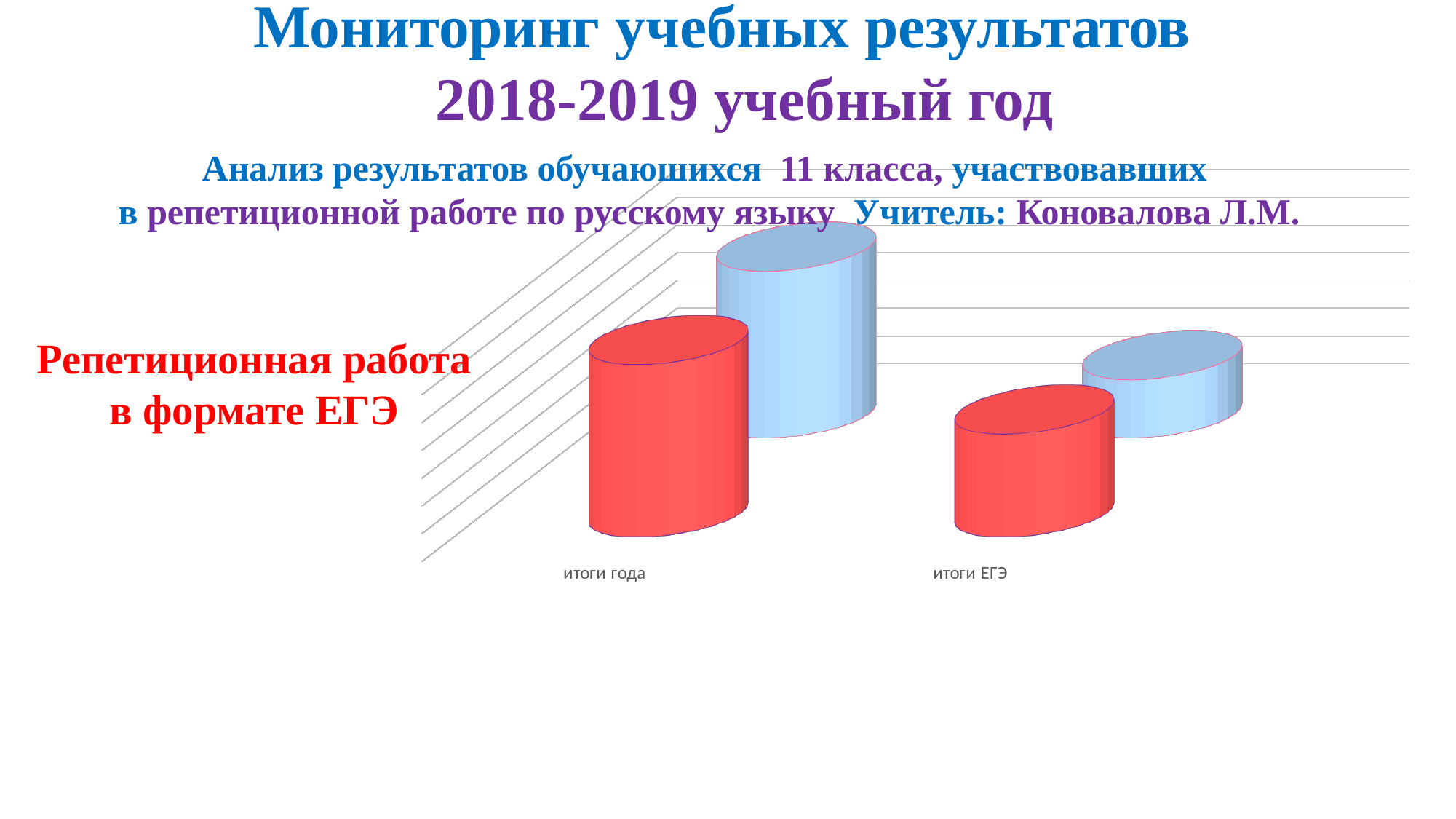
Do the values of the red series rise or fall from итоги года to итоги ЕГЭ? fall For the red series, which category has the lowest value? итоги ЕГЭ What kind of chart is shown on the slide? bar chart For the red series, which category has the higher value: итоги года or итоги ЕГЭ? итоги года For the blue series, which category has the highest value? итоги года What two colours are used for the bars in the chart? red and light blue Do the values of the blue series rise or fall from итоги года to итоги ЕГЭ? fall For the blue series, which category has the higher value: итоги года or итоги ЕГЭ? итоги года How many categories are shown on the x axis of the chart? 2 What are the two category labels on the x axis of the chart? итоги года, итоги ЕГЭ